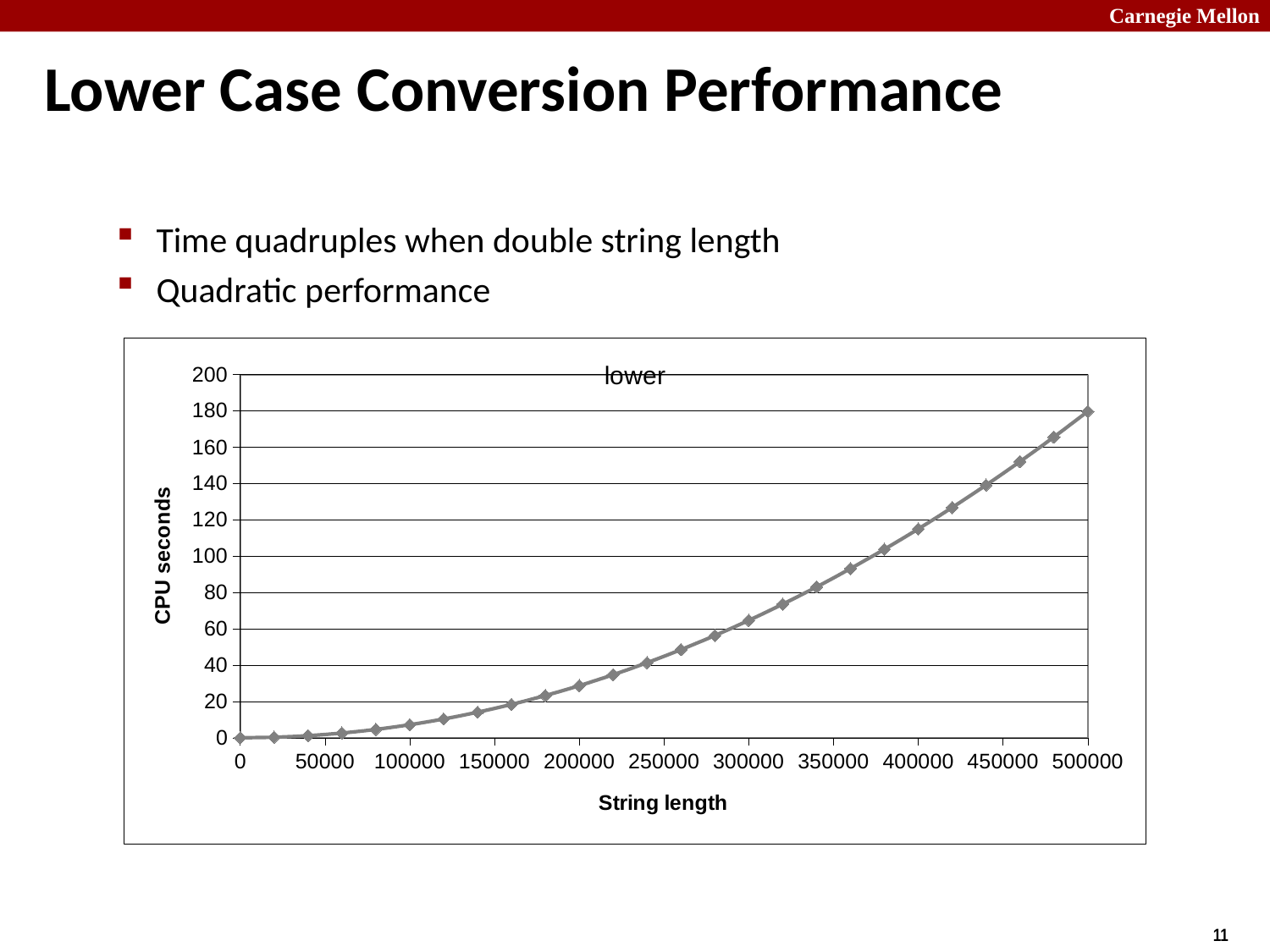
Do the CPU seconds rise or fall as string length increases? rise Is the CPU time at string length 300000 greater or less than 40? greater What kind of chart is shown on the slide? line chart Which has the larger CPU time: string length 400000 or string length 200000? 400000 At which string length is the CPU time highest? 500000 Is the CPU time at string length 100000 greater or less than 20? less Is the CPU time at string length 200000 greater or less than 40? less How many data points are plotted on the line? 26 What is the title of the chart? lower What is the label of the y axis? CPU seconds At which string length is the CPU time lowest? 0